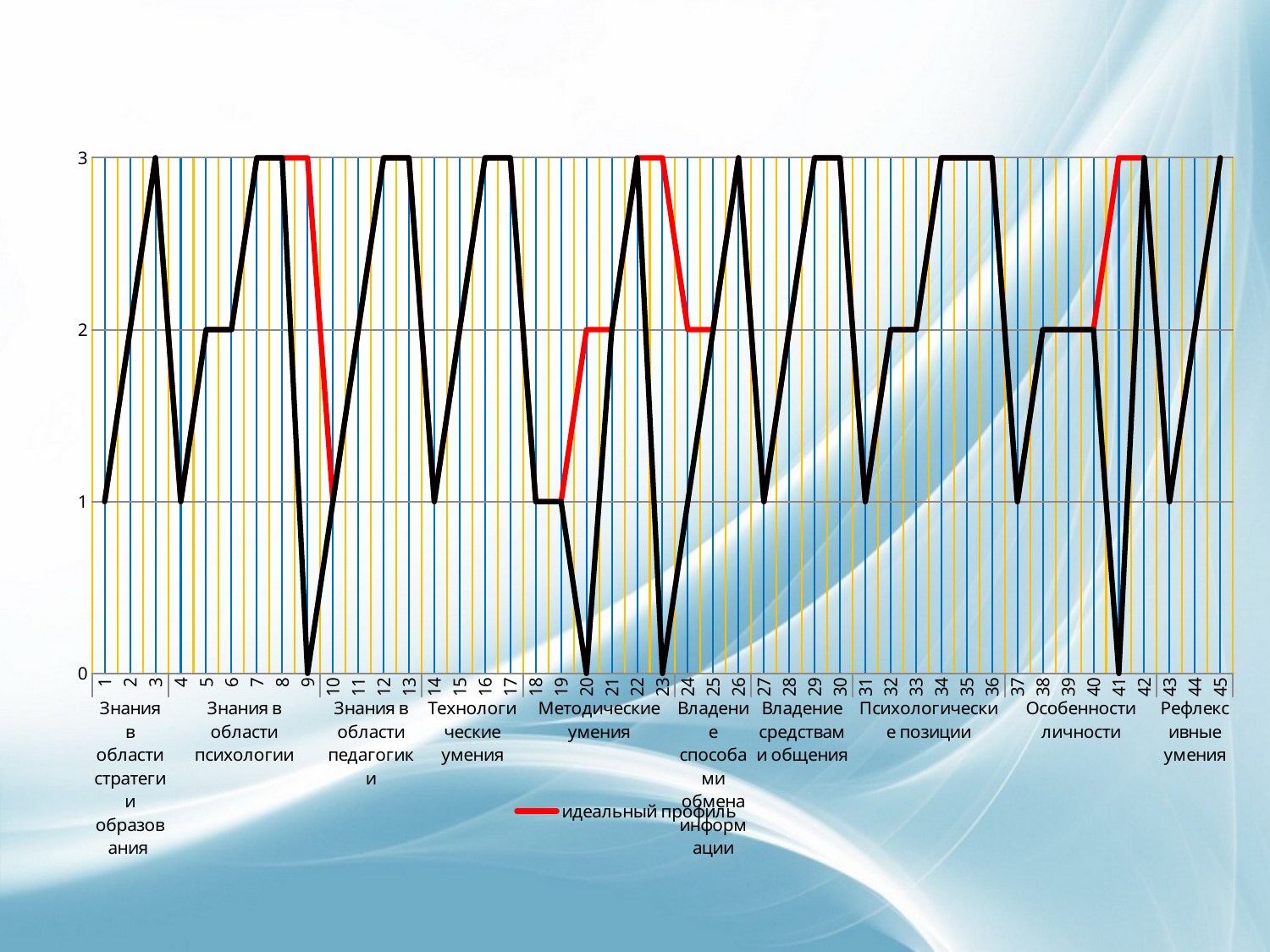
What is the name of the series shown in the legend? идеальный профиль What is the value at point 1? 1 What is the value of the red 'идеальный профиль' line at point 23? 3 What is the value of the black line at point 20? 0 What is the difference between the value at point 3 and the value at point 4? 2 What kind of chart is shown on the slide? line chart How many series does the legend list? 1 What colour is the line for 'идеальный профиль' in the legend? red What is the value of the black line at point 9? 0 Which is larger, the value at point 3 or the value at point 4? point 3 How many numbered points are plotted along the x axis? 45 What is the value of the red 'идеальный профиль' line at point 9? 3